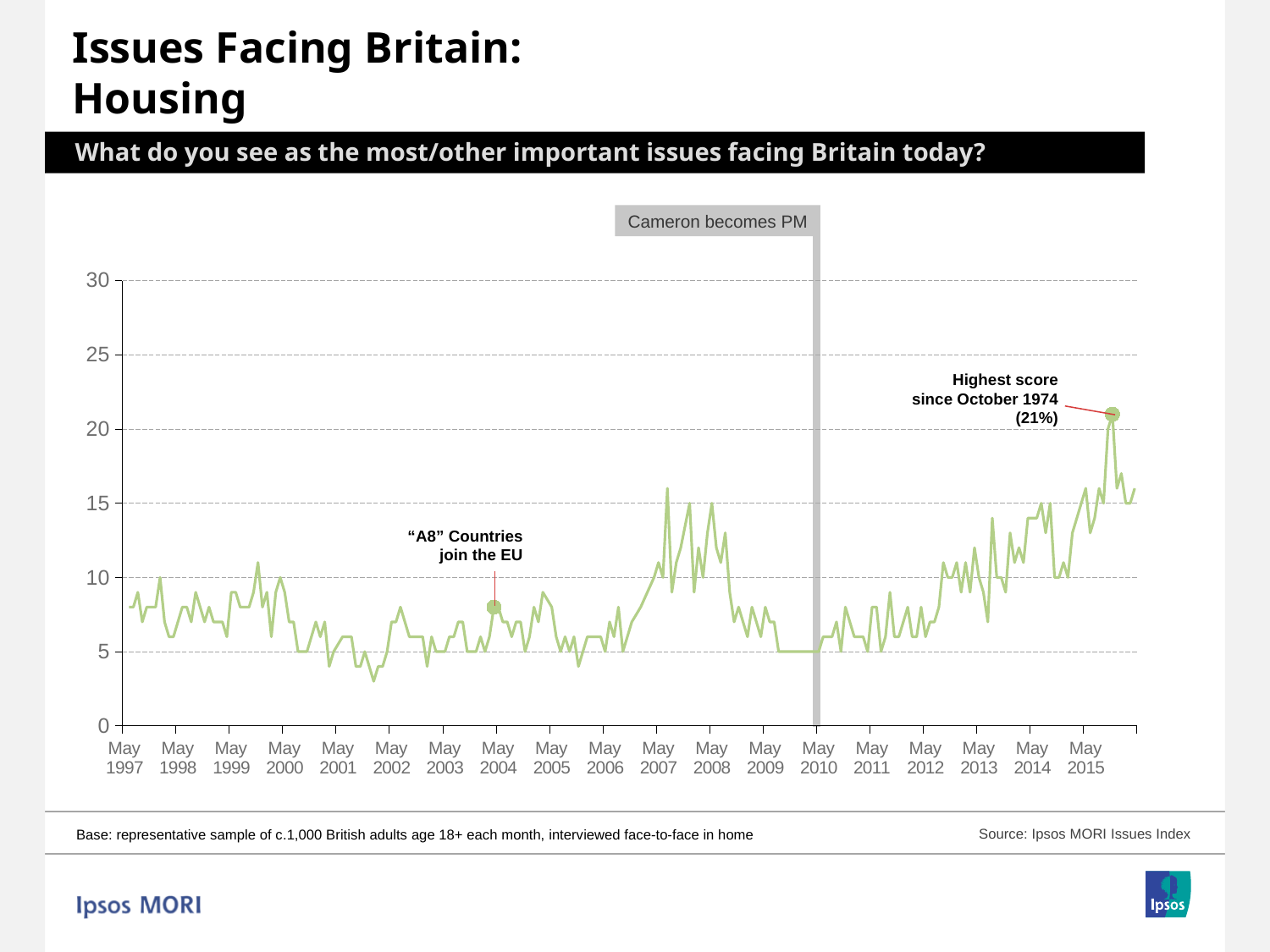
According to the annotation, the peak of 21% is the highest score since when? October 1974 Which event does the grey vertical bar at May 2010 mark? Cameron becomes PM Is the value for May 2002 greater or less than 10? less Is the value for May 2010 greater or less than 10? less What is the highest value shown on the chart, as labelled in the annotation? 21% Does the line generally rise or fall between May 2012 and May 2015? rise Is the value for May 2015 greater or less than 10? greater How many 'May' year labels are shown on the x axis? 19 What kind of chart is shown on the slide? line chart Which is larger, the value for May 2015 or the value for May 2010? May 2015